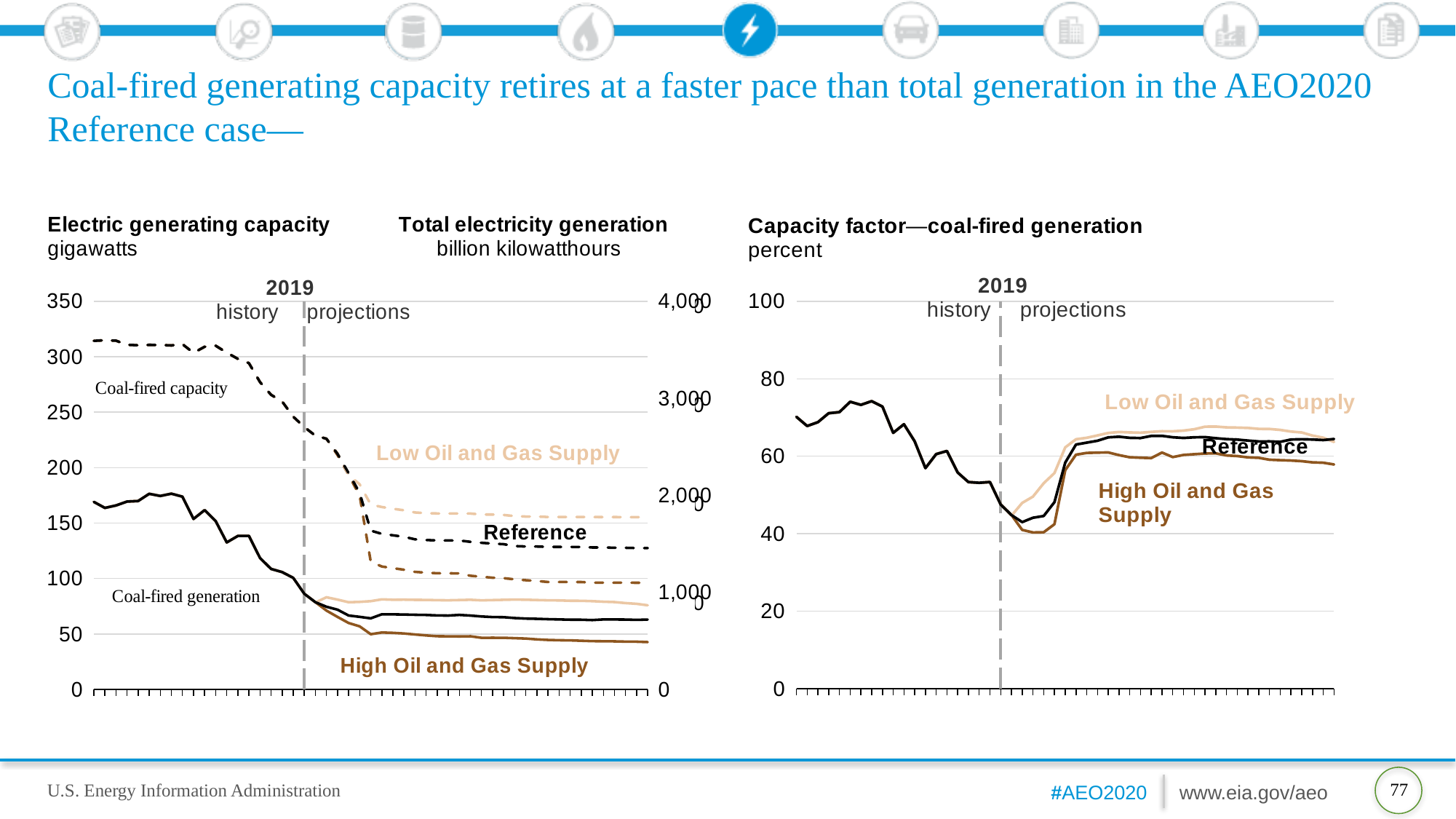
How many projection scenarios are labelled in the 'Capacity factor—coal-fired generation' chart? 3 In the 'Electric generating capacity' chart, which scenario has the higher coal-fired capacity at the end of the projection period, Low Oil and Gas Supply or High Oil and Gas Supply? Low Oil and Gas Supply In the 'Electric generating capacity' chart, what year separates history from projections? 2019 In the 'Electric generating capacity' chart, is the coal-fired capacity at the start of the history period greater or less than 300 gigawatts? greater In the 'Electric generating capacity' chart, is the Reference case coal-fired capacity at the end of the projection period greater or less than 150 gigawatts? less What kind of chart is the 'Capacity factor—coal-fired generation' chart? line chart What unit is shown on the right-hand axis of the 'Electric generating capacity' chart? billion kilowatthours In the 'Electric generating capacity' chart, is the Low Oil and Gas Supply coal-fired capacity at the end of the projection period greater or less than 200 gigawatts? less In the 'Capacity factor—coal-fired generation' chart, which scenario has the higher capacity factor at the end of the projection period, Low Oil and Gas Supply or High Oil and Gas Supply? Low Oil and Gas Supply In the 'Electric generating capacity' chart, does coal-fired capacity rise or fall over the history period? fall